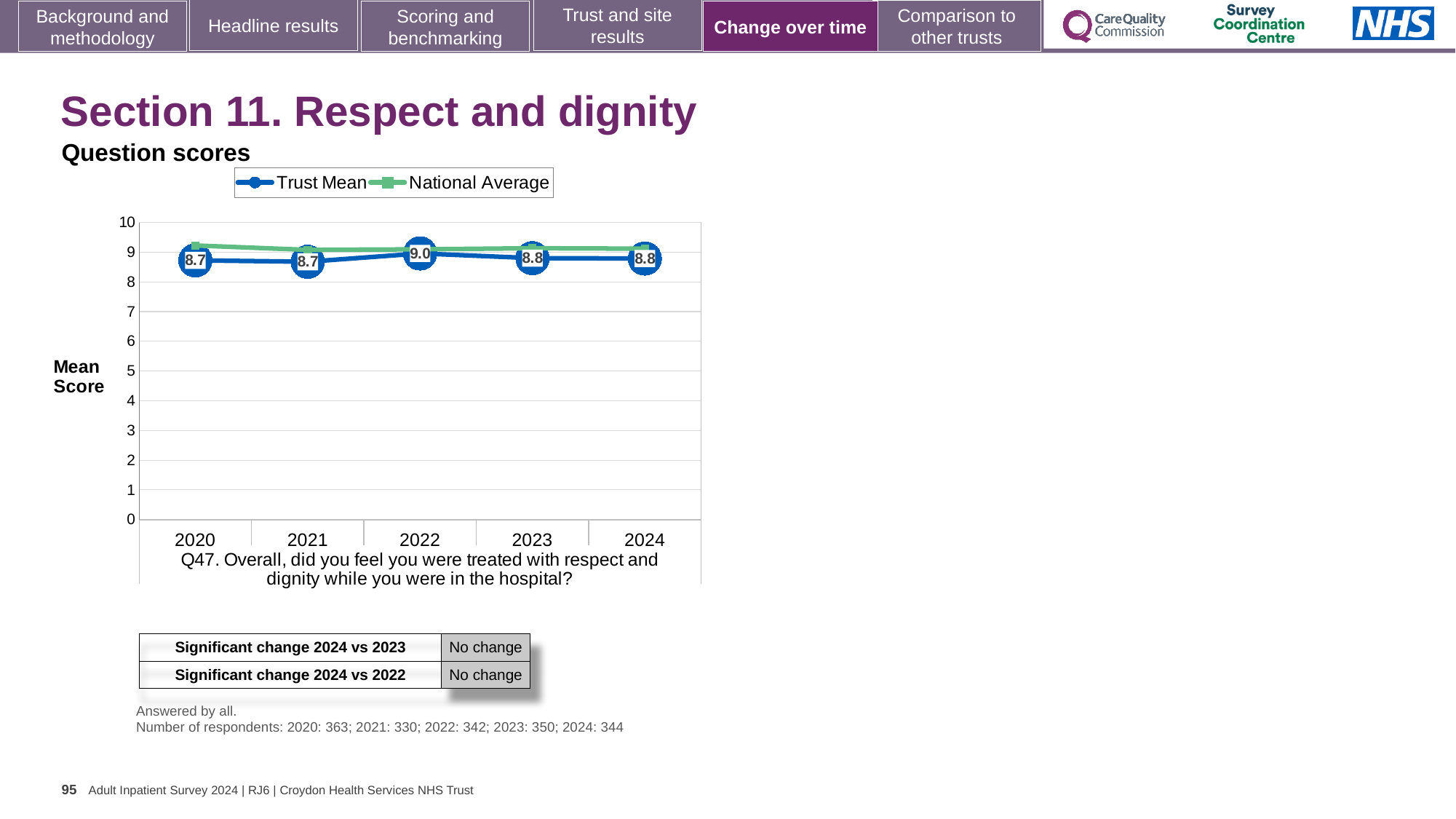
In which year is the Trust Mean score highest? 2022 How many years are plotted on the x axis? 5 What is the difference between the Trust Mean score in 2022 and in 2021? 0.3 What is the Trust Mean score for 2024? 8.8 What is the Trust Mean score for 2020? 8.7 Which year has the larger Trust Mean score, 2022 or 2023? 2022 What kind of chart is shown? Line chart What is the Trust Mean score for 2022? 9.0 How many series does the legend list? 2 What are the two series named in the legend? Trust Mean and National Average Is the National Average value for 2020 greater or less than 9? greater Did the Trust Mean score rise or fall from 2021 to 2022? Rise